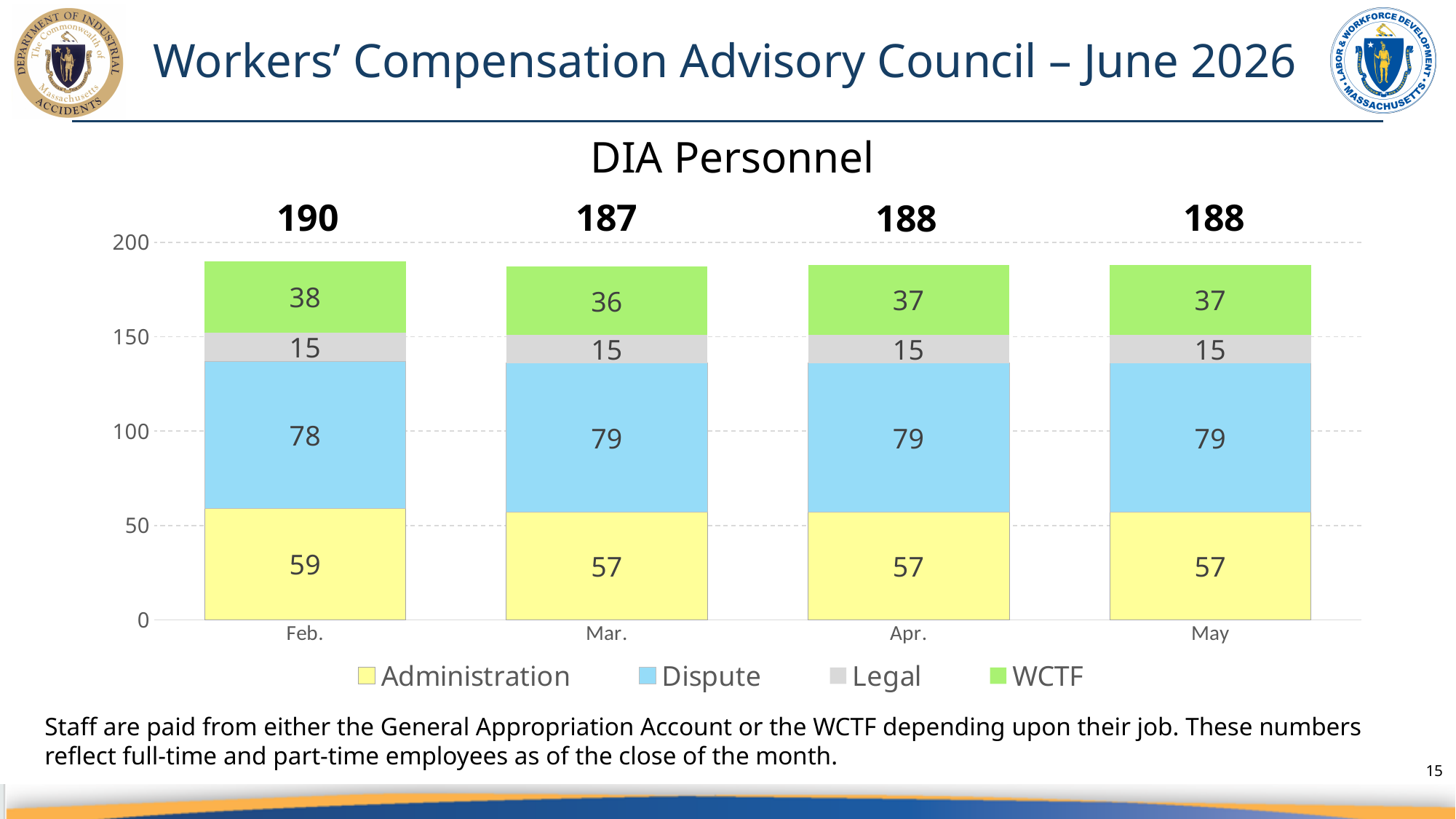
Which month has the lowest total DIA personnel? Mar. How many months are shown on the x axis? 4 What is the difference between the WCTF value for Feb. and the WCTF value for Mar.? 2 What is the total of the stacked bar for Mar.? 187 What kind of chart is shown? Stacked bar chart Which is larger, the Administration value for Feb. or the Administration value for May? Feb. What is the Administration value for Feb.? 59 What is the Legal value for May? 15 What is the WCTF value for Mar.? 36 Which month has the highest total DIA personnel? Feb. What is the Dispute value for Apr.? 79 How many series does the legend list? 4